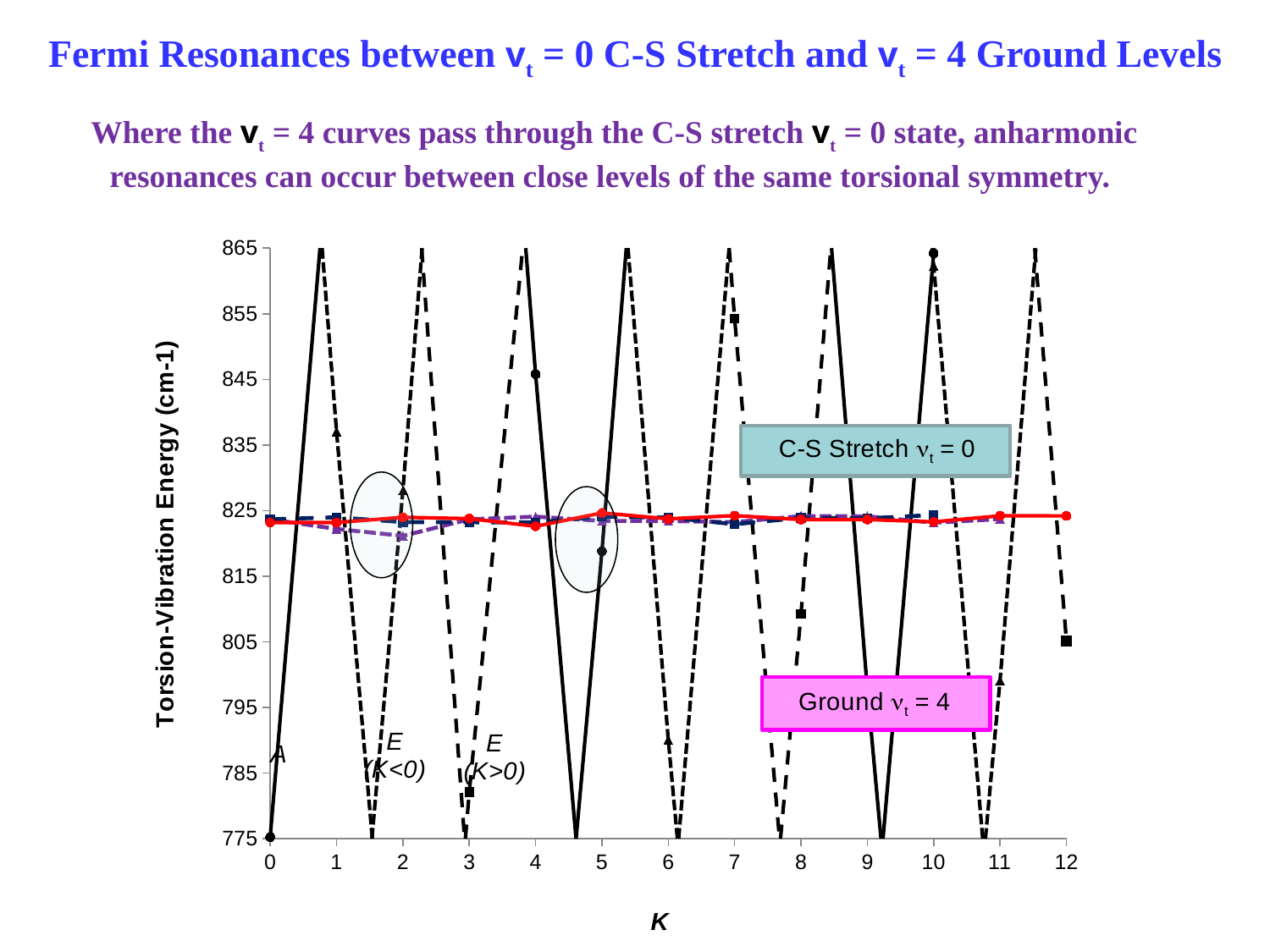
Is the value of the black circle marker at K = 4 greater or less than 835? greater What is the title of the y axis of the chart? Torsion-Vibration Energy (cm-1) How many K values are labelled along the x axis of the chart? 13 Is the value of the red line at K = 12 greater or less than 815? greater Is the value of the black triangle marker at K = 6 greater or less than 805? less What kind of chart is shown on the slide? line chart What is the title of the x axis of the chart? K